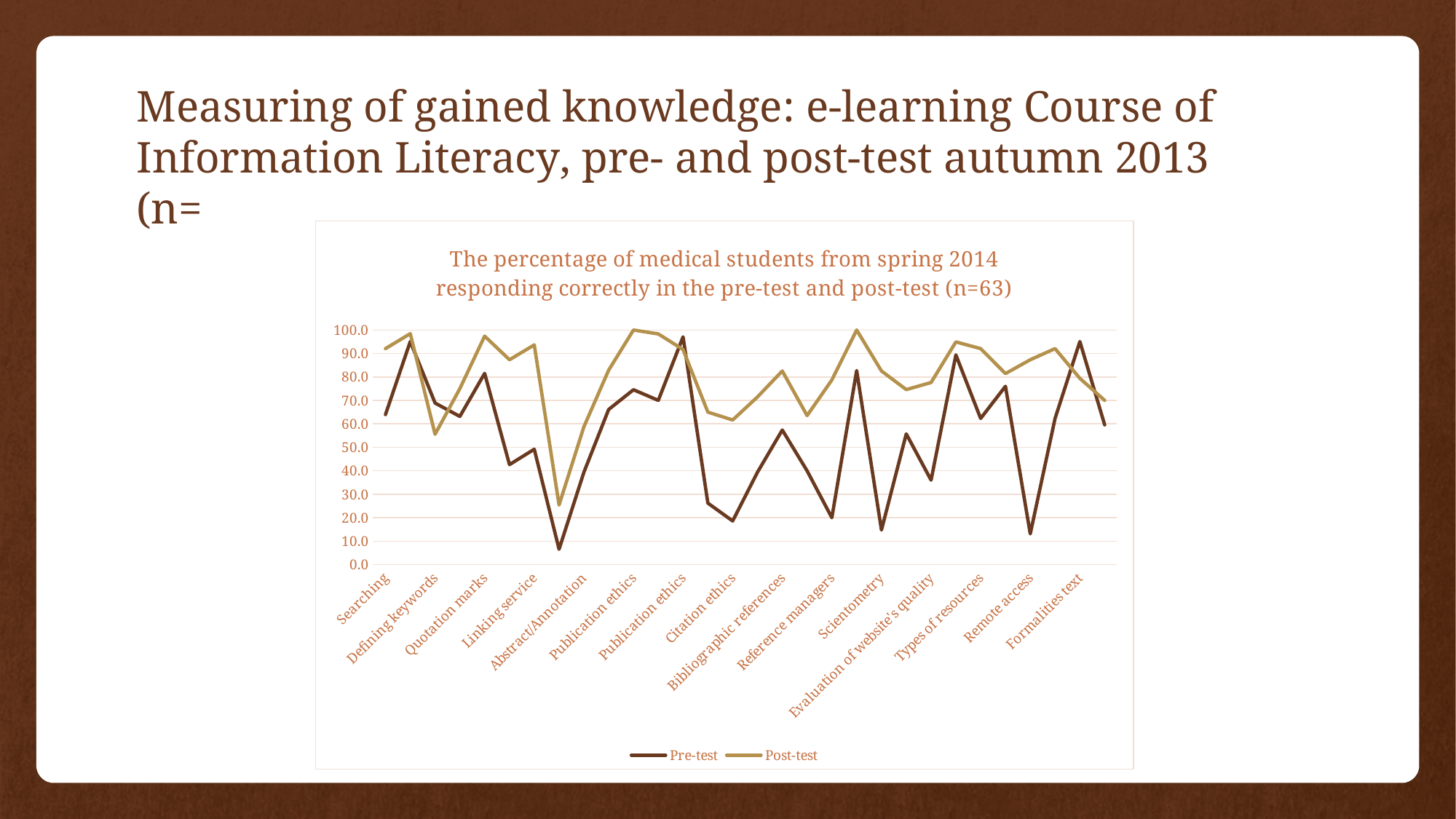
For Searching, which is larger: the Pre-test value or the Post-test value? Post-test For Formalities text, which is larger: the Pre-test value or the Post-test value? Pre-test Is the Post-test value for Defining keywords greater or less than 60.0? less What kind of chart is shown on the slide? Line chart Is the Pre-test value for Remote access greater or less than 20.0? less What is the title of the chart? The percentage of medical students from spring 2014 responding correctly in the pre-test and post-test (n=63) How many series does the chart legend list? 2